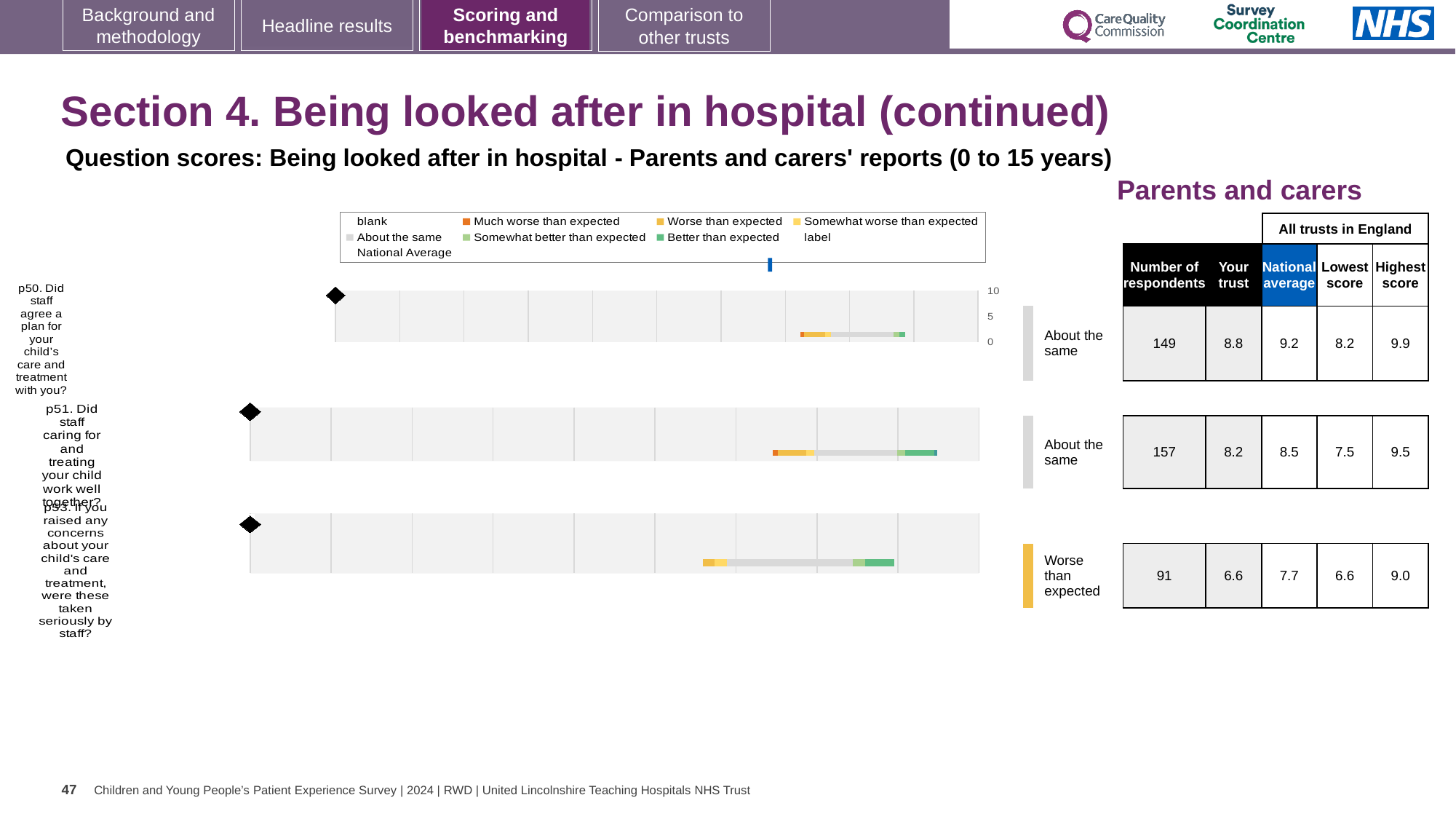
For p50, what is the difference between the highest score and the lowest score across all trusts in England? 1.7 Which question has the highest 'Your trust' score? p50 For p53 (If you raised any concerns about your child's care and treatment, were these taken seriously by staff?), how many respondents were there? 91 How many survey questions (charts) are shown on the slide? 3 What benchmark category is shown for p53? Worse than expected For p53, what is the difference between the national average and the 'Your trust' score? 1.1 For p51, which is larger: the 'Your trust' score or the national average? National average For p51 (Did staff caring for and treating your child work well together?), what is the national average score? 8.5 Which question has the lowest 'Your trust' score? p53 What kind of chart is used to show the question scores on this slide? bar chart What is the title of the chart section on this slide? Question scores: Being looked after in hospital - Parents and carers' reports (0 to 15 years) For p50 (Did staff agree a plan for your child's care and treatment with you?), what is the 'Your trust' score? 8.8